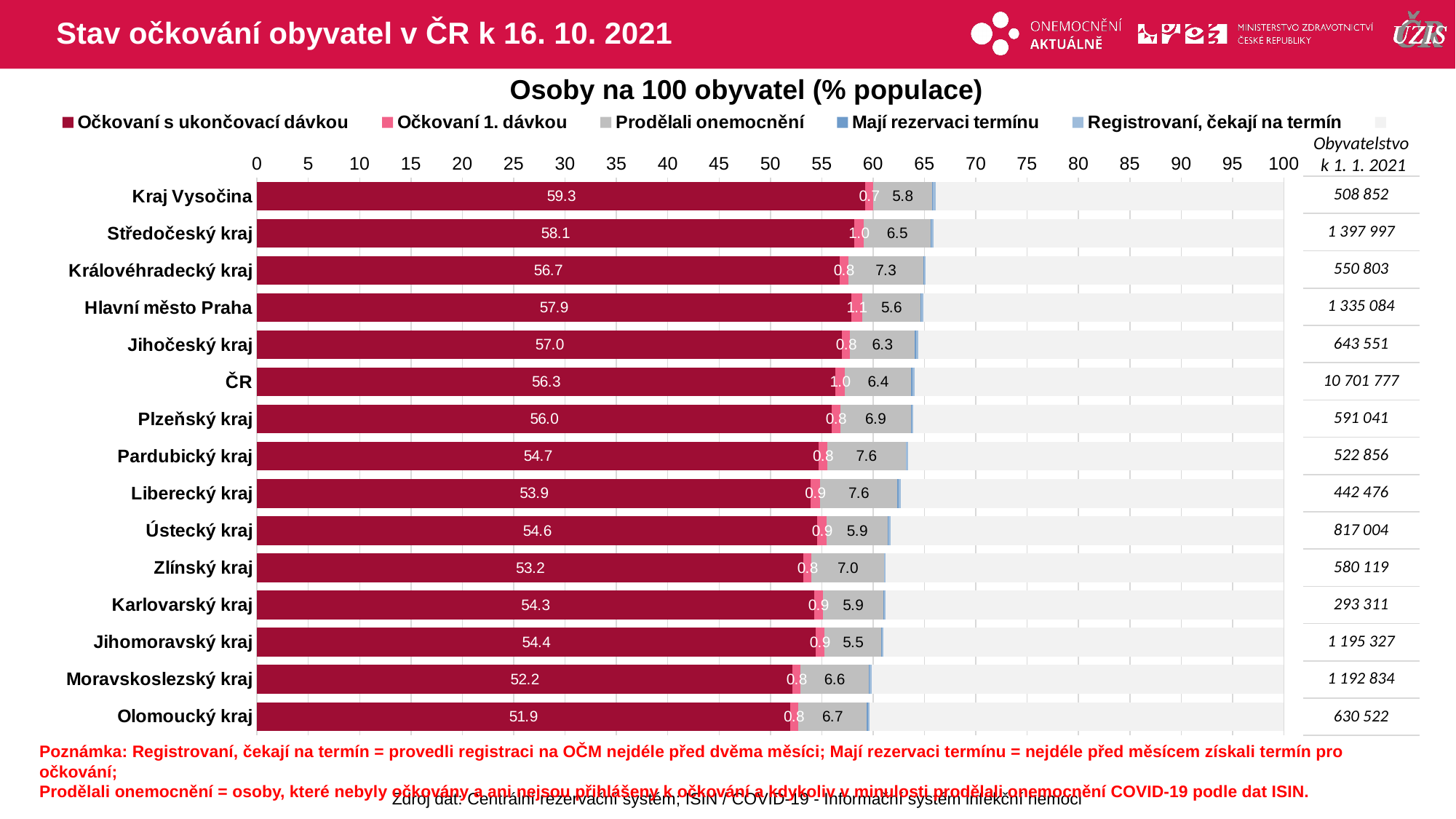
What is the title of the chart? Osoby na 100 obyvatel (% populace) What kind of chart is shown on the slide? bar chart Which region has the lowest value of Očkovaní s ukončovací dávkou? Olomoucký kraj What is the value of Prodělali onemocnění for Pardubický kraj? 7.6 Which has a larger value of Prodělali onemocnění, Královéhradecký kraj or Jihočeský kraj? Královéhradecký kraj Which region has the highest value of Očkovaní s ukončovací dávkou? Kraj Vysočina What is the value of Očkovaní s ukončovací dávkou for Kraj Vysočina? 59.3 What is the value of Očkovaní s ukončovací dávkou for ČR? 56.3 What is the value of Očkovaní 1. dávkou for Hlavní město Praha? 1.1 Do the values of Očkovaní s ukončovací dávkou rise or fall going down the list of regions from top to bottom? fall What is the difference in Očkovaní s ukončovací dávkou between Kraj Vysočina and Olomoucký kraj? 7.4 How many regions (categories) are plotted in the chart? 15